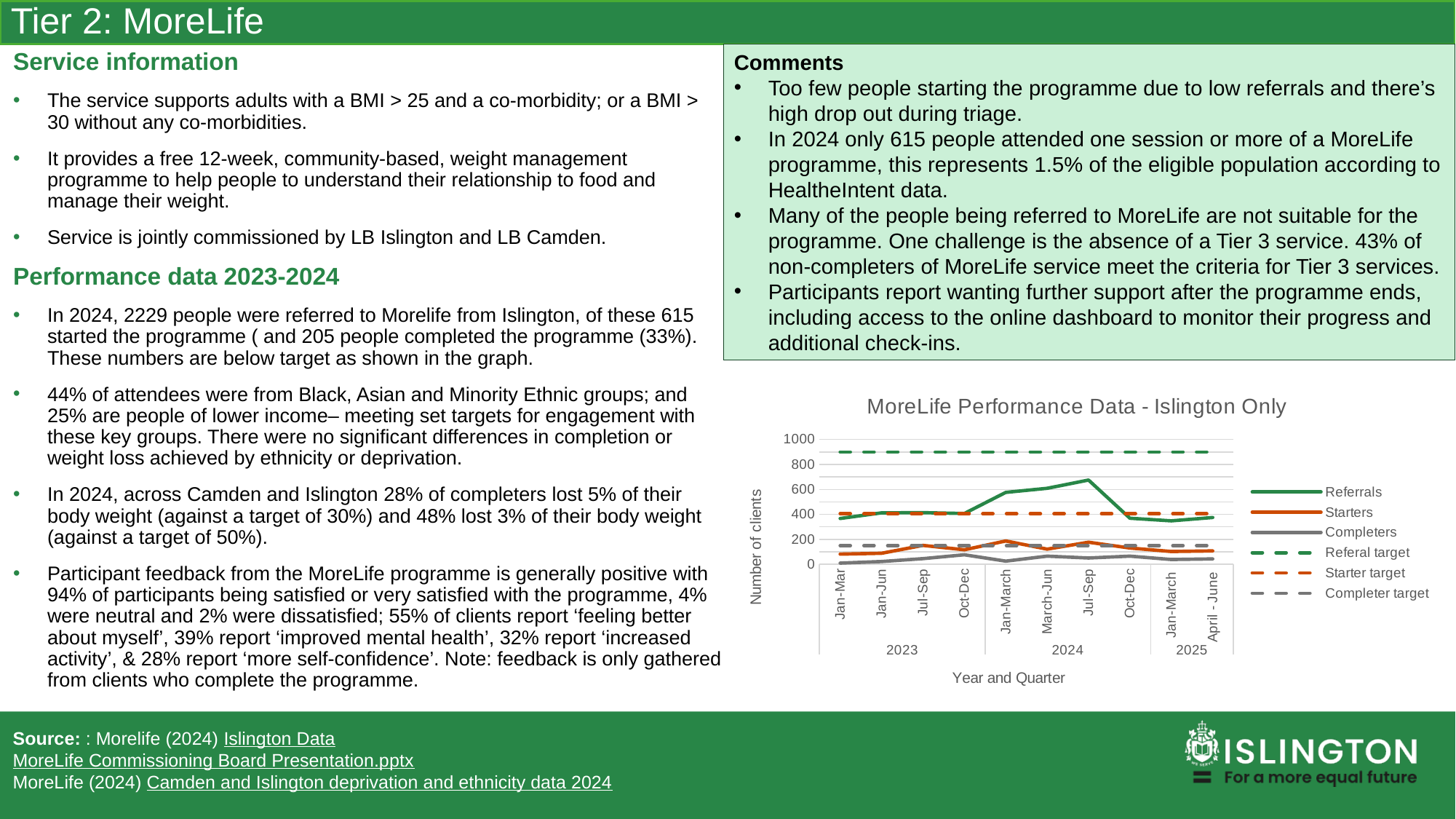
In the 'MoreLife Performance Data - Islington Only' chart, is the Referal target line greater or less than 800? greater In the 'MoreLife Performance Data - Islington Only' chart, is the Completers value for Jan-Mar 2023 greater or less than 200? less How many quarters are plotted along the x axis of the 'MoreLife Performance Data - Islington Only' chart? 10 What is the x-axis title of the 'MoreLife Performance Data - Islington Only' chart? Year and Quarter What is the title of the chart on the slide? MoreLife Performance Data - Islington Only In the 'MoreLife Performance Data - Islington Only' chart, in which quarter do Referrals reach their highest value? Jul-Sep 2024 In the 'MoreLife Performance Data - Islington Only' chart, is the Referrals value for Jul-Sep 2024 greater or less than 600? greater How many series does the legend of the 'MoreLife Performance Data - Islington Only' chart list? 6 In the 'MoreLife Performance Data - Islington Only' chart, which is larger in Jan-March 2024: Referrals or Starters? Referrals What type of chart is 'MoreLife Performance Data - Islington Only'? line chart In the 'MoreLife Performance Data - Islington Only' chart, do Referrals rise or fall from Jul-Sep 2024 to Oct-Dec 2024? fall